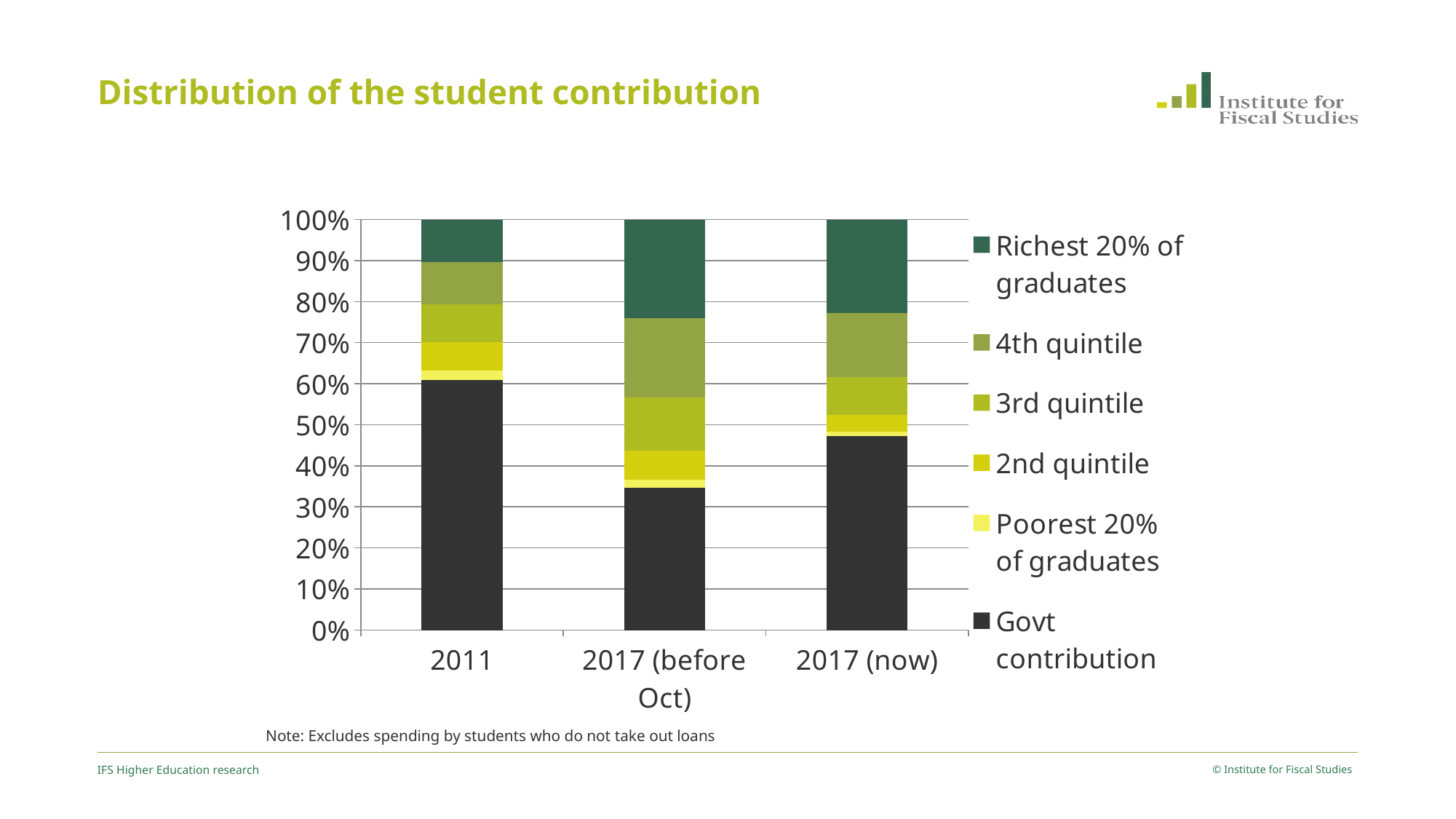
Which is larger, the Richest 20% of graduates share in 2011 or in 2017 (before Oct)? 2017 (before Oct) What is the total of the stacked bar for 2011? 100% Which category has the smallest Govt contribution share? 2017 (before Oct) How many series does the legend list? 6 What kind of chart is shown on the slide? Stacked bar chart Is the Govt contribution share for 2017 (before Oct) greater or less than 40%? less Which category has the largest Govt contribution share? 2011 How many categories are shown on the x axis? 3 Is the Govt contribution share for 2017 (now) greater or less than 40%? greater Is the Govt contribution share for 2011 greater or less than 50%? greater What is the title of the chart? Distribution of the student contribution Which is larger, the Govt contribution share in 2011 or in 2017 (now)? 2011